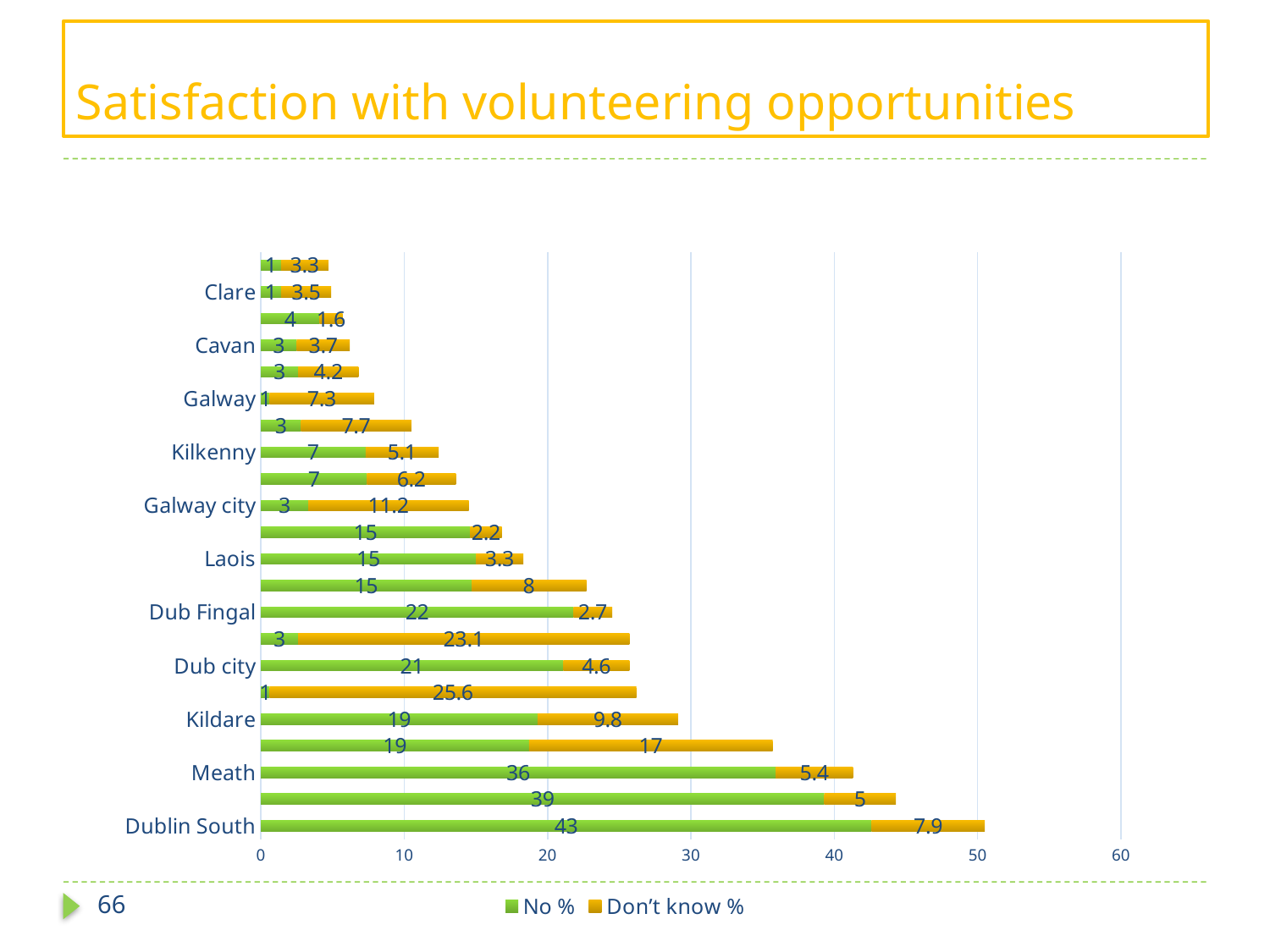
What is the Don't know % value for Kildare? 9.8 What is the total of the stacked bar for Dublin South (No % plus Don't know %)? 50.9 What is the difference between the No % values for Dublin South and Meath? 7 What is the No % value for Dublin South? 43 How many series does the legend list? 2 What is the total of the stacked bar for Kildare (No % plus Don't know %)? 28.8 What kind of chart is shown on the slide? Stacked bar chart What is the No % value for Meath? 36 What is the Don't know % value for Galway city? 11.2 Which has the larger No % value, Kilkenny or Galway city? Kilkenny Is the total length of the Dub Fingal bar greater or less than 30? less Which labelled area has the highest No % value? Dublin South